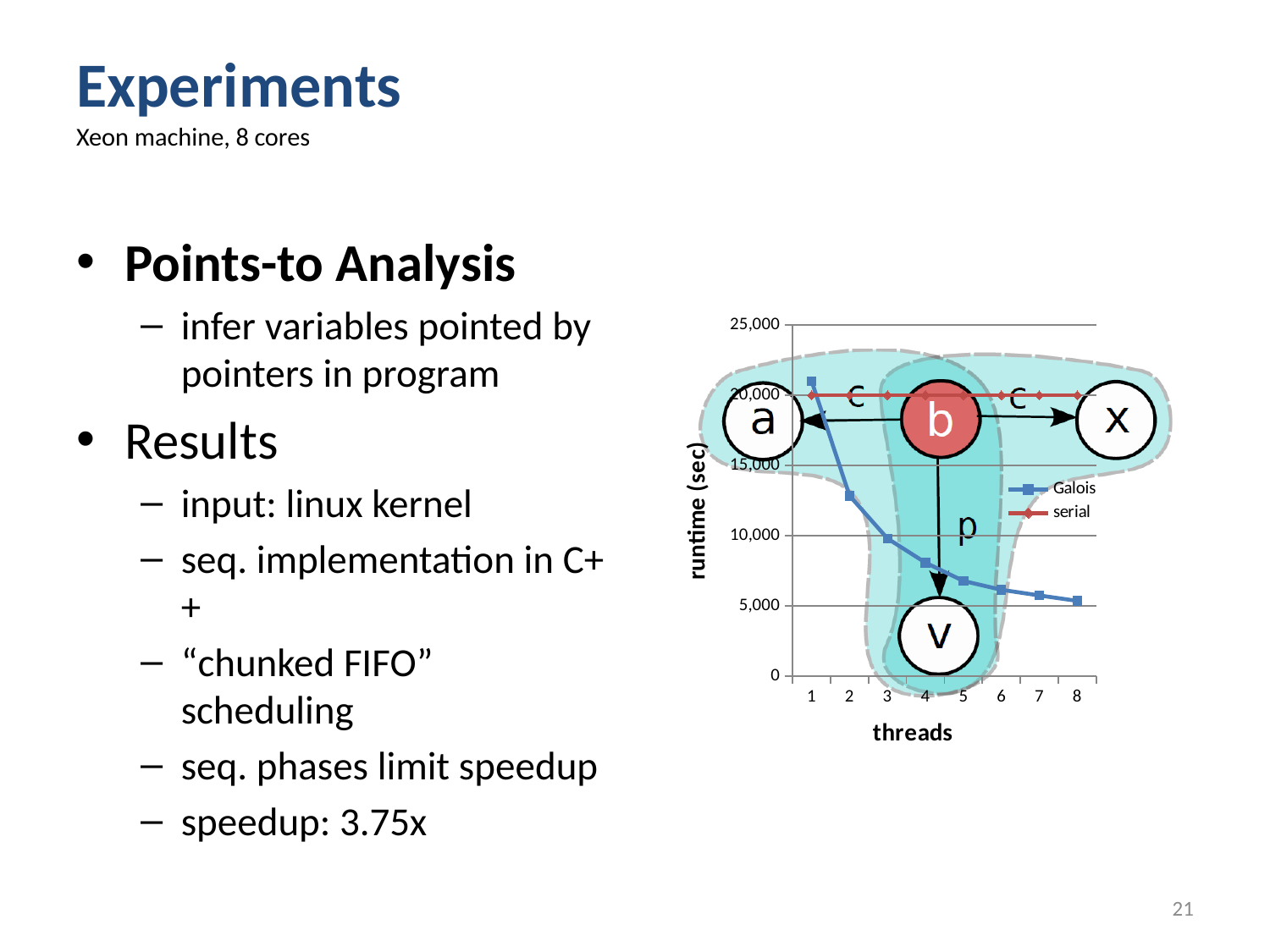
What is the label of the y axis of the chart? runtime (sec) How many series does the chart legend list? 2 What kind of chart is shown on the slide? line chart Is the serial runtime at 8 threads greater or less than 15,000? greater At which number of threads is the Galois runtime highest? 1 Is the Galois runtime at 2 threads greater or less than 10,000? greater Is the Galois runtime at 8 threads greater or less than 10,000? less What are the two series named in the chart legend? Galois and serial At which number of threads is the Galois runtime lowest? 8 At 8 threads, which series has the larger runtime, Galois or serial? serial How many thread counts are plotted along the x axis of the chart? 8 Does the Galois runtime rise or fall as the number of threads increases? fall